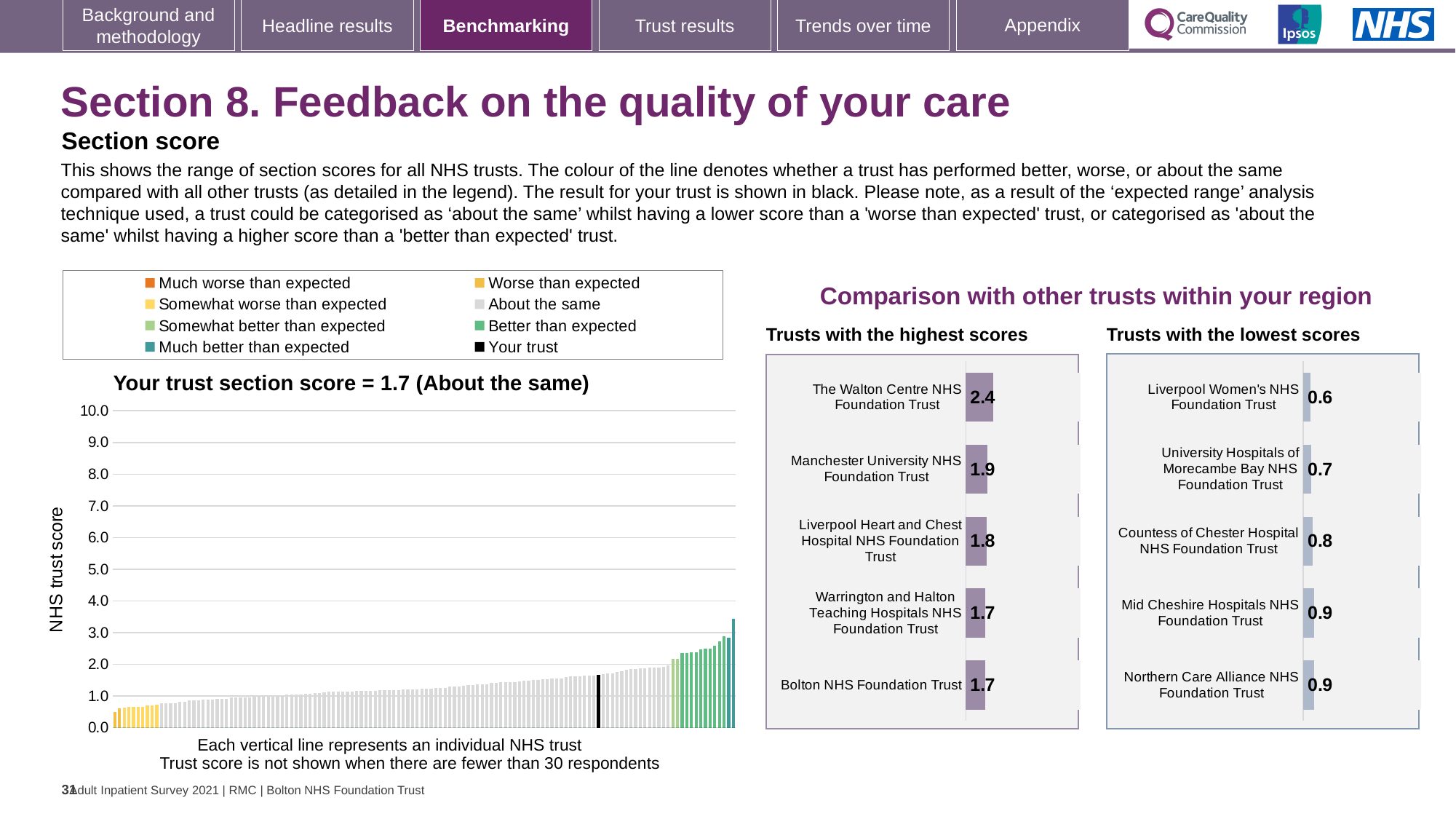
In the 'Your trust section score' chart, what is the section score for your trust? 1.7 In the 'Your trust section score' chart, how many entries does the legend list? 8 In the 'Your trust section score' chart, do the trust scores rise or fall from left to right? rise In the 'Trusts with the highest scores' chart, what is the difference between The Walton Centre NHS Foundation Trust and Bolton NHS Foundation Trust? 0.7 In the 'Trusts with the highest scores' chart, what is the score for The Walton Centre NHS Foundation Trust? 2.4 In the 'Trusts with the lowest scores' chart, which trust has the lowest score? Liverpool Women's NHS Foundation Trust What kind of chart is the 'Your trust section score' chart? bar chart In the 'Trusts with the lowest scores' chart, which is larger: the score for Mid Cheshire Hospitals NHS Foundation Trust or University Hospitals of Morecambe Bay NHS Foundation Trust? Mid Cheshire Hospitals NHS Foundation Trust In the 'Your trust section score' chart, is the value for your trust (the black bar) greater or less than 2.0? less In the 'Trusts with the highest scores' chart, how many trusts are shown? 5 In the 'Trusts with the highest scores' chart, which trust has the highest score? The Walton Centre NHS Foundation Trust In the 'Trusts with the lowest scores' chart, what is the score for Countess of Chester Hospital NHS Foundation Trust? 0.8